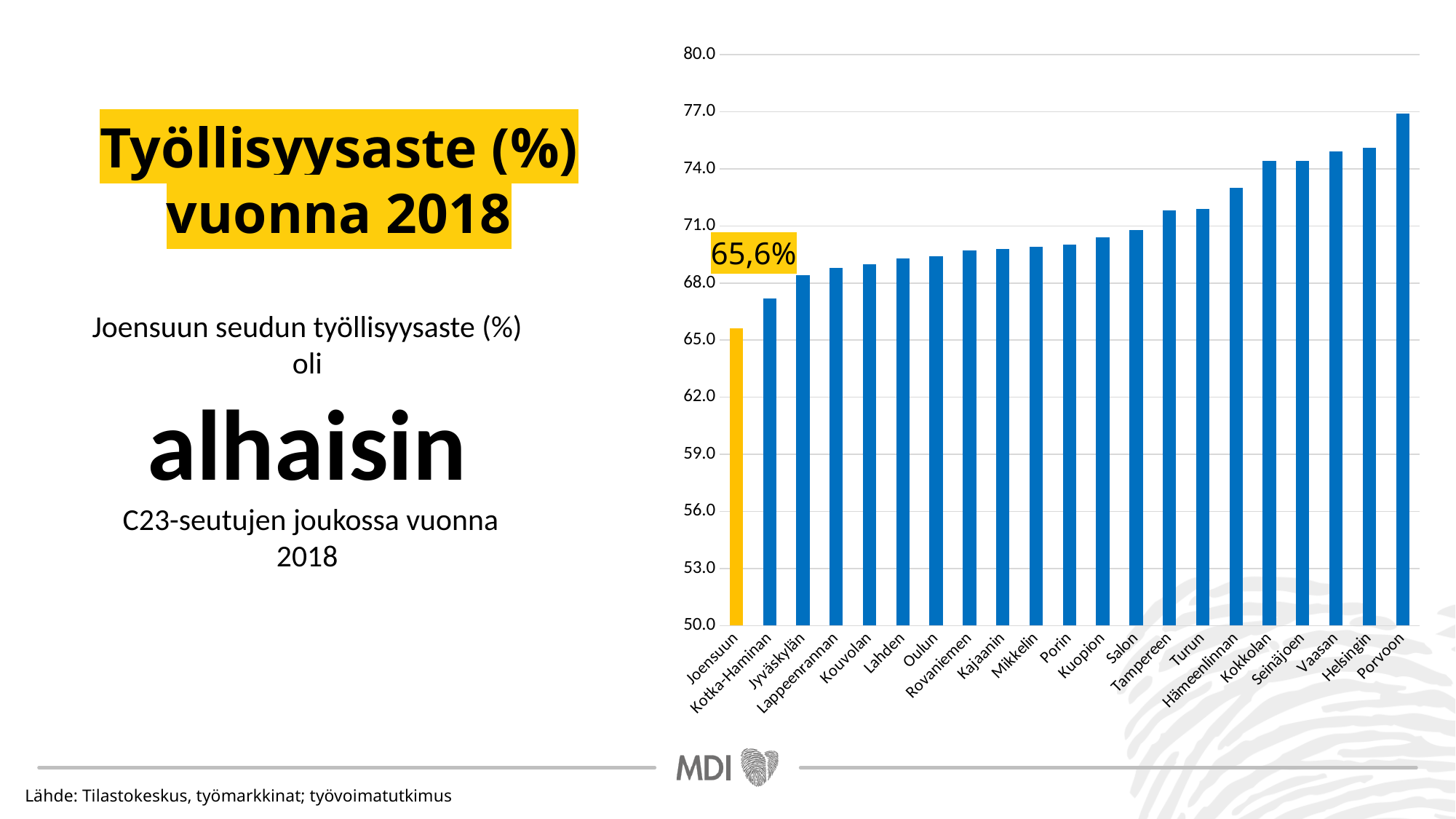
How many regions are shown in the chart? 21 Do the values rise or fall moving from left to right along the x axis? Rise Is the value for Hämeenlinnan greater or less than 71.0? greater Which has a higher employment rate, Porvoon or Helsingin? Porvoon Which region's bar is highlighted in yellow instead of blue? Joensuun Is the value for Kotka-Haminan greater or less than 68.0? less Which region has the highest employment rate in the chart? Porvoon What kind of chart is shown on the slide? Bar chart Which region has the lowest employment rate in the chart? Joensuun Is the value for Porvoon greater or less than 74.0? greater Which has a higher employment rate, Joensuun or Kotka-Haminan? Kotka-Haminan What is the employment rate shown for Joensuun? 65,6%